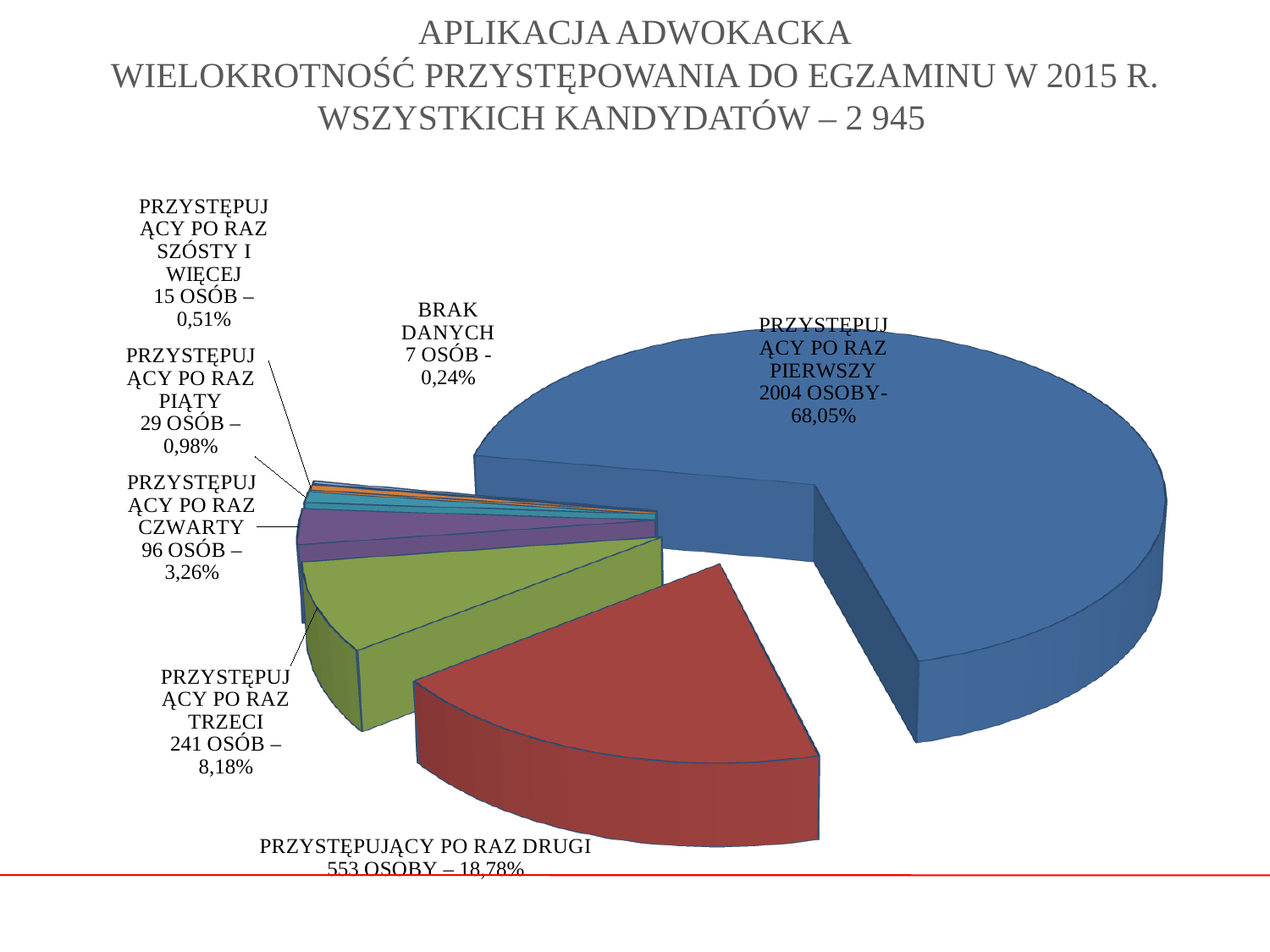
How many people took the exam for the first time (PRZYSTĘPUJĄCY PO RAZ PIERWSZY)? 2004 What percentage is shown for PRZYSTĘPUJĄCY PO RAZ CZWARTY? 3,26% What is the total number of candidates given in the chart title? 2 945 Which category has the smallest slice of the pie? BRAK DANYCH What colour is the slice for PRZYSTĘPUJĄCY PO RAZ DRUGI? Red What is the difference in number of people between PRZYSTĘPUJĄCY PO RAZ DRUGI and PRZYSTĘPUJĄCY PO RAZ TRZECI? 312 Which is larger: PRZYSTĘPUJĄCY PO RAZ PIĄTY or PRZYSTĘPUJĄCY PO RAZ SZÓSTY I WIĘCEJ? PRZYSTĘPUJĄCY PO RAZ PIĄTY What share of the pie is PRZYSTĘPUJĄCY PO RAZ DRUGI? 18,78% How many people are in the PRZYSTĘPUJĄCY PO RAZ TRZECI category? 241 How many slices does the pie chart have? 7 Which category has the largest slice of the pie? PRZYSTĘPUJĄCY PO RAZ PIERWSZY What kind of chart is shown on the slide? Pie chart